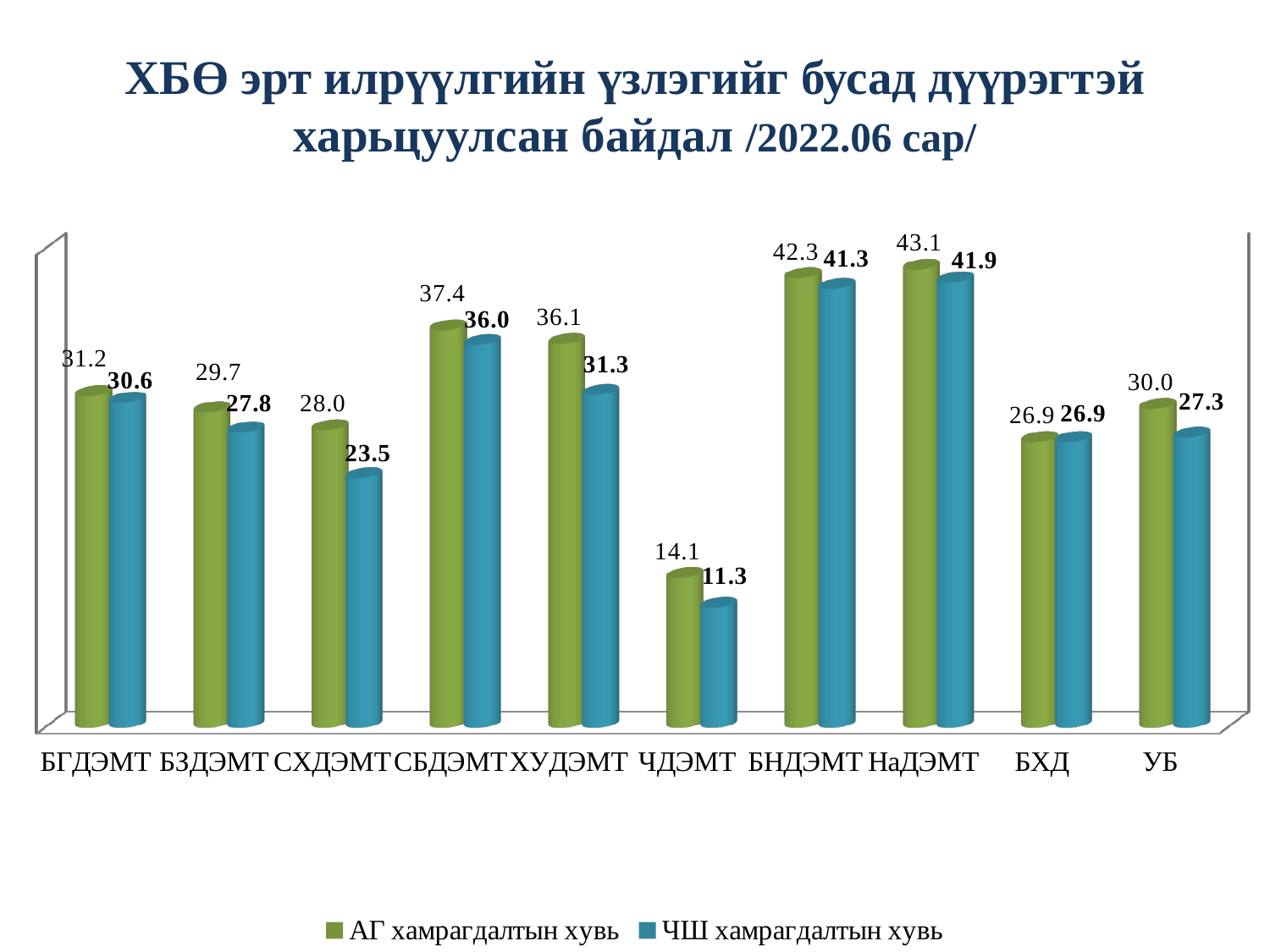
What is the difference between the АГ хамрагдалтын хувь and ЧШ хамрагдалтын хувь values for СХДЭМТ? 4.5 Which category has the lowest ЧШ хамрагдалтын хувь value? ЧДЭМТ Which series is shown in green? АГ хамрагдалтын хувь Which category has the highest АГ хамрагдалтын хувь value? НаДЭМТ Which is larger, the ЧШ хамрагдалтын хувь value for БЗДЭМТ or for СХДЭМТ? БЗДЭМТ What kind of chart is shown on the slide? Bar chart What is the АГ хамрагдалтын хувь value for СБДЭМТ? 37.4 What is the difference between the АГ хамрагдалтын хувь values for НаДЭМТ and ЧДЭМТ? 29.0 How many categories are shown on the x axis? 10 How many series does the legend list? 2 What is the ЧШ хамрагдалтын хувь value for УБ? 27.3 What is the ЧШ хамрагдалтын хувь value for ХУДЭМТ? 31.3